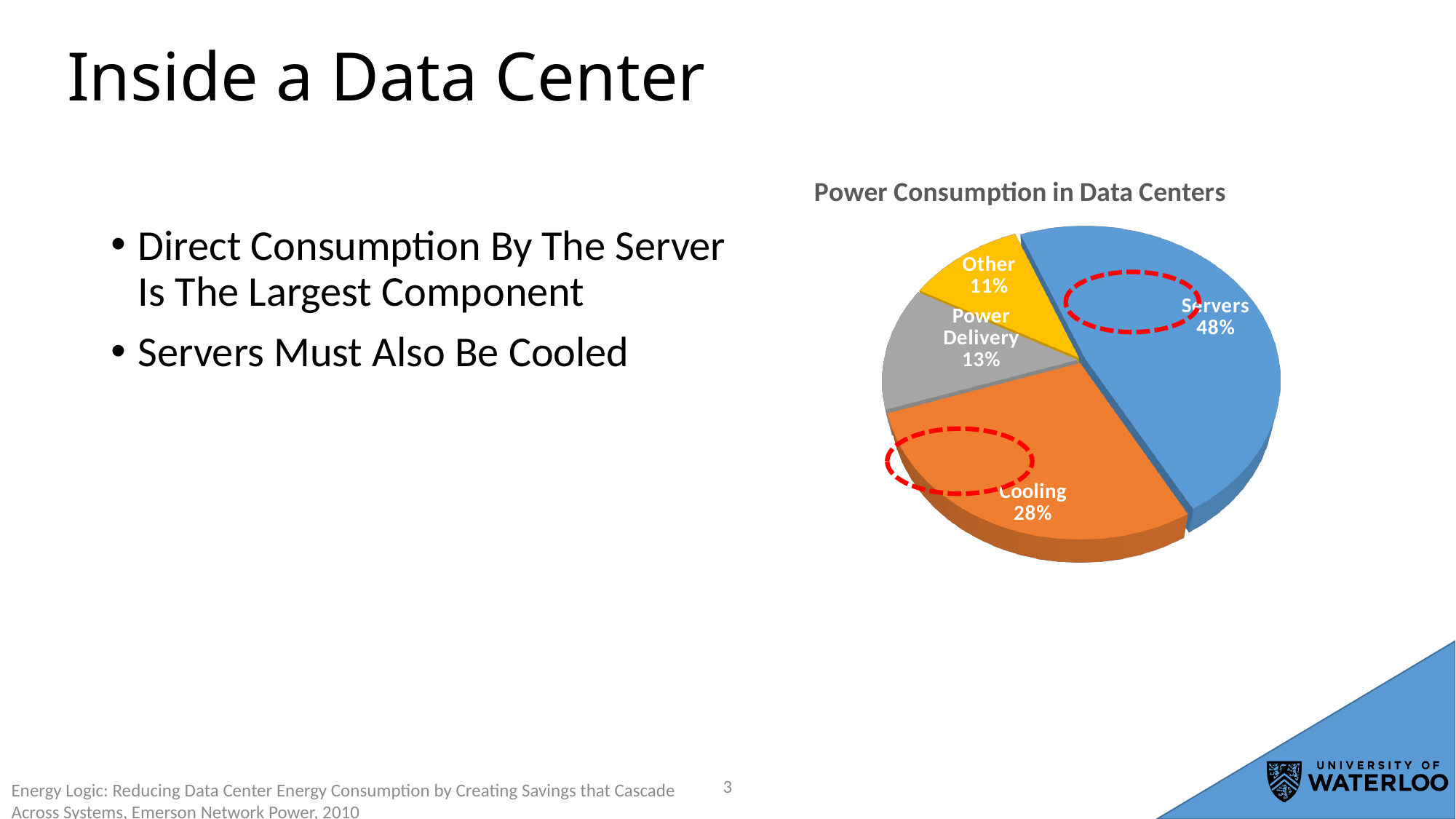
What is the title of the chart? Power Consumption in Data Centers What share of power consumption in data centers is attributed to Cooling? 28% What share of power consumption in data centers is attributed to Servers? 48% Which has a larger share of power consumption, Power Delivery or Other? Power Delivery What share of power consumption in data centers is attributed to Other? 11% What is the difference in percentage points between the Servers share and the Cooling share? 20 What share of power consumption in data centers is attributed to Power Delivery? 13% How many categories are shown in the pie chart? 4 What colour is the Cooling slice of the pie chart? Orange Which category has the largest share of power consumption in data centers? Servers Which category has the smallest share of power consumption in data centers? Other What kind of chart is shown on the slide? Pie chart